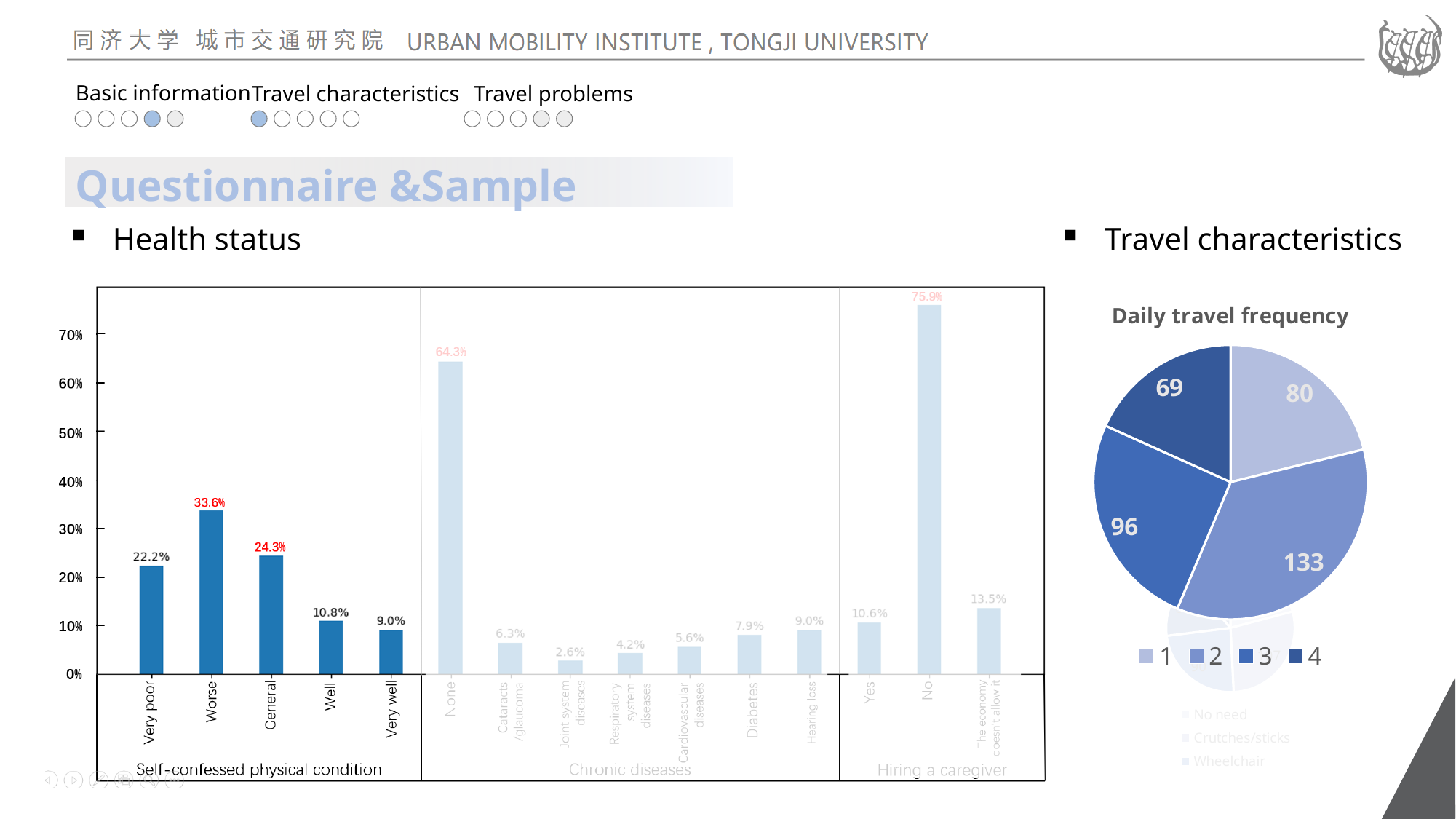
In the Health status bar chart, which Self-confessed physical condition category has the highest value? Worse In the Health status bar chart, what is the value for None under Chronic diseases? 64.3% In the Health status bar chart, how many categories are shown under Self-confessed physical condition? 5 In the Health status bar chart, what is the value for No under Hiring a caregiver? 75.9% In the Daily travel frequency pie chart, which series has the smallest slice? 4 In the Health status bar chart, what is the difference between Very poor (22.2%) and Very well (9.0%)? 13.2% In the Health status bar chart, which Chronic diseases category has the lowest value? Joint system diseases In the Health status bar chart, which is larger: Diabetes or Hearing loss? Hearing loss In the Health status bar chart, what is the value for Worse under Self-confessed physical condition? 33.6% How many entries does the legend of the Daily travel frequency pie chart list? 4 What kind of chart is the Health status chart? Bar chart In the Daily travel frequency pie chart, what is the value for series 2? 133